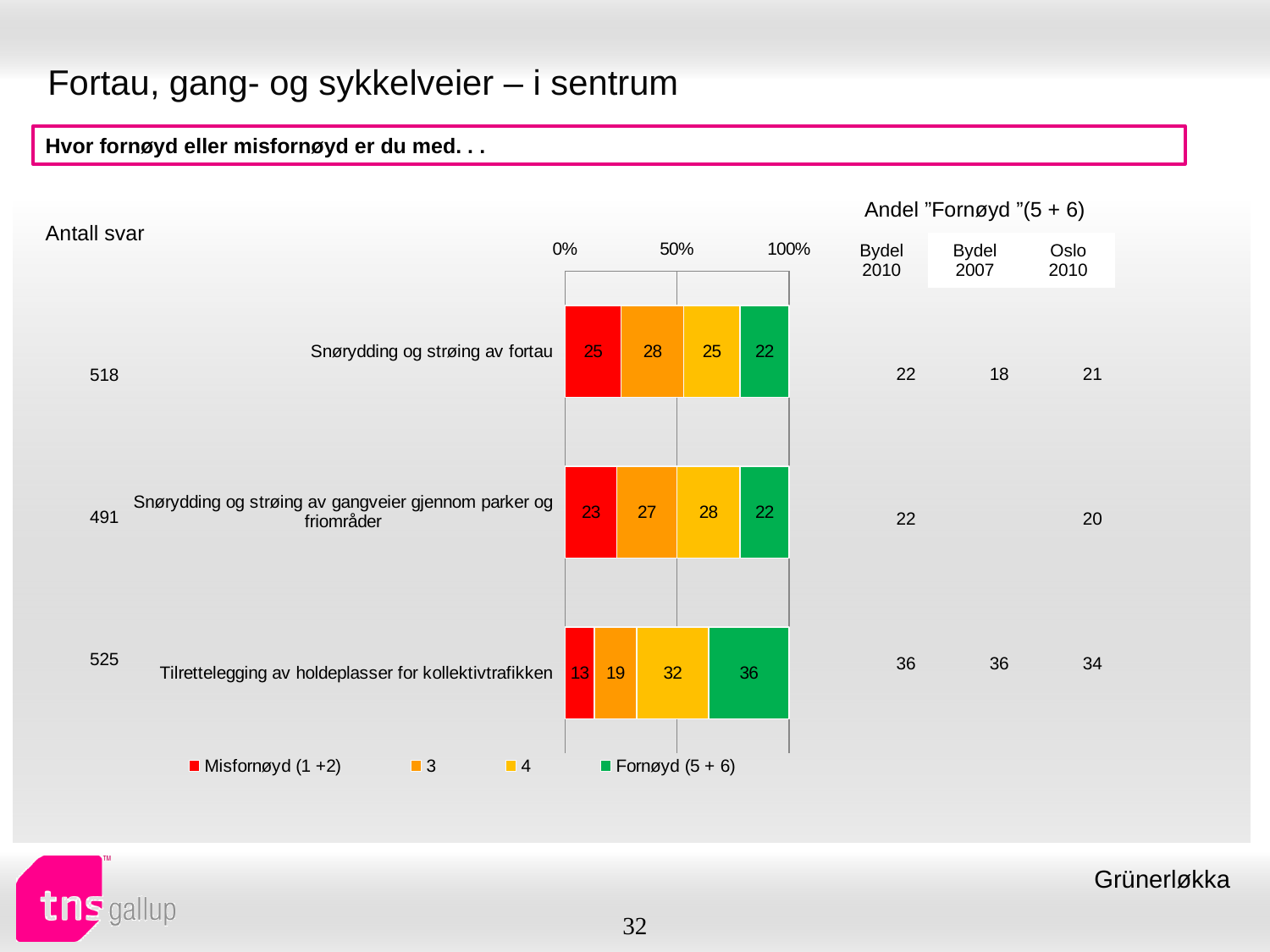
Which category has the larger "Misfornøyd (1 +2)" value: "Snørydding og strøing av fortau" or "Snørydding og strøing av gangveier gjennom parker og friområder"? Snørydding og strøing av fortau What is the total of the stacked bar for "Snørydding og strøing av fortau"? 100 What is the value of the "Fornøyd (5 + 6)" segment for "Tilrettelegging av holdeplasser for kollektivtrafikken"? 36 How many series does the legend list? 4 What is the value of the "4" segment for "Snørydding og strøing av gangveier gjennom parker og friområder"? 28 What kind of chart is shown on the slide? Stacked bar chart What is the value of the "3" segment for "Tilrettelegging av holdeplasser for kollektivtrafikken"? 19 Which category has the highest "Fornøyd (5 + 6)" value? Tilrettelegging av holdeplasser for kollektivtrafikken Which category has the lowest "Misfornøyd (1 +2)" value? Tilrettelegging av holdeplasser for kollektivtrafikken How many categories are shown in the chart? 3 What is the difference between the "Fornøyd (5 + 6)" value for "Tilrettelegging av holdeplasser for kollektivtrafikken" and for "Snørydding og strøing av fortau"? 14 What is the value of the "Misfornøyd (1 +2)" segment for "Snørydding og strøing av fortau"? 25